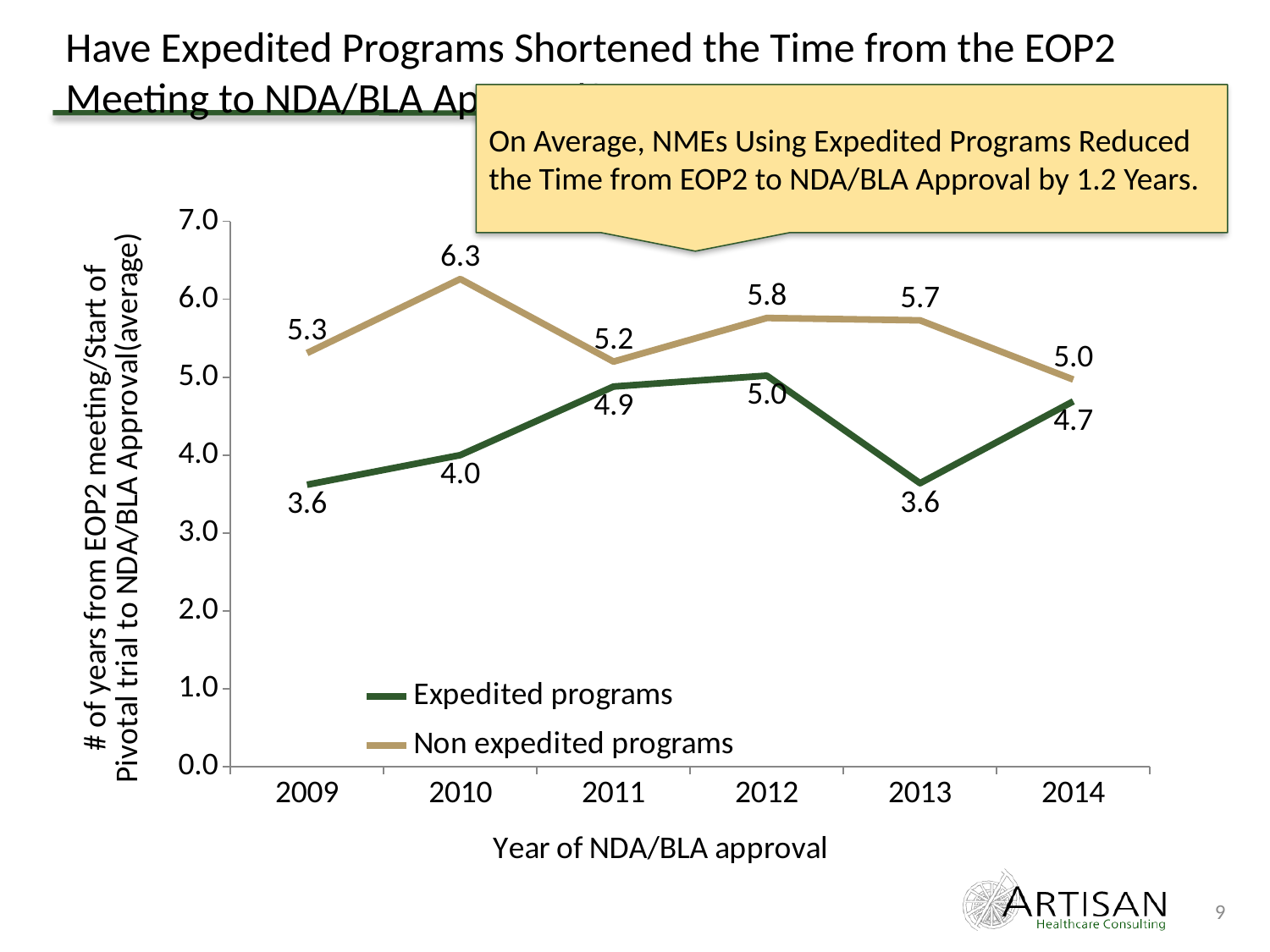
What kind of chart is shown on the slide? line chart In which year is the Non expedited programs value lowest? 2014 What is the value for Expedited programs in 2011? 4.9 What is the difference between Non expedited programs and Expedited programs in 2014? 0.3 In which year is the Non expedited programs value highest? 2010 How many series does the legend list? 2 Which is larger in 2012, the Expedited programs value or the Non expedited programs value? Non expedited programs What is the value for Expedited programs in 2013? 3.6 How many years are shown on the x axis? 6 Is the value for Expedited programs in 2010 greater or less than 5.0? less What is the difference between Non expedited programs and Expedited programs in 2009? 1.7 What is the value for Non expedited programs in 2010? 6.3